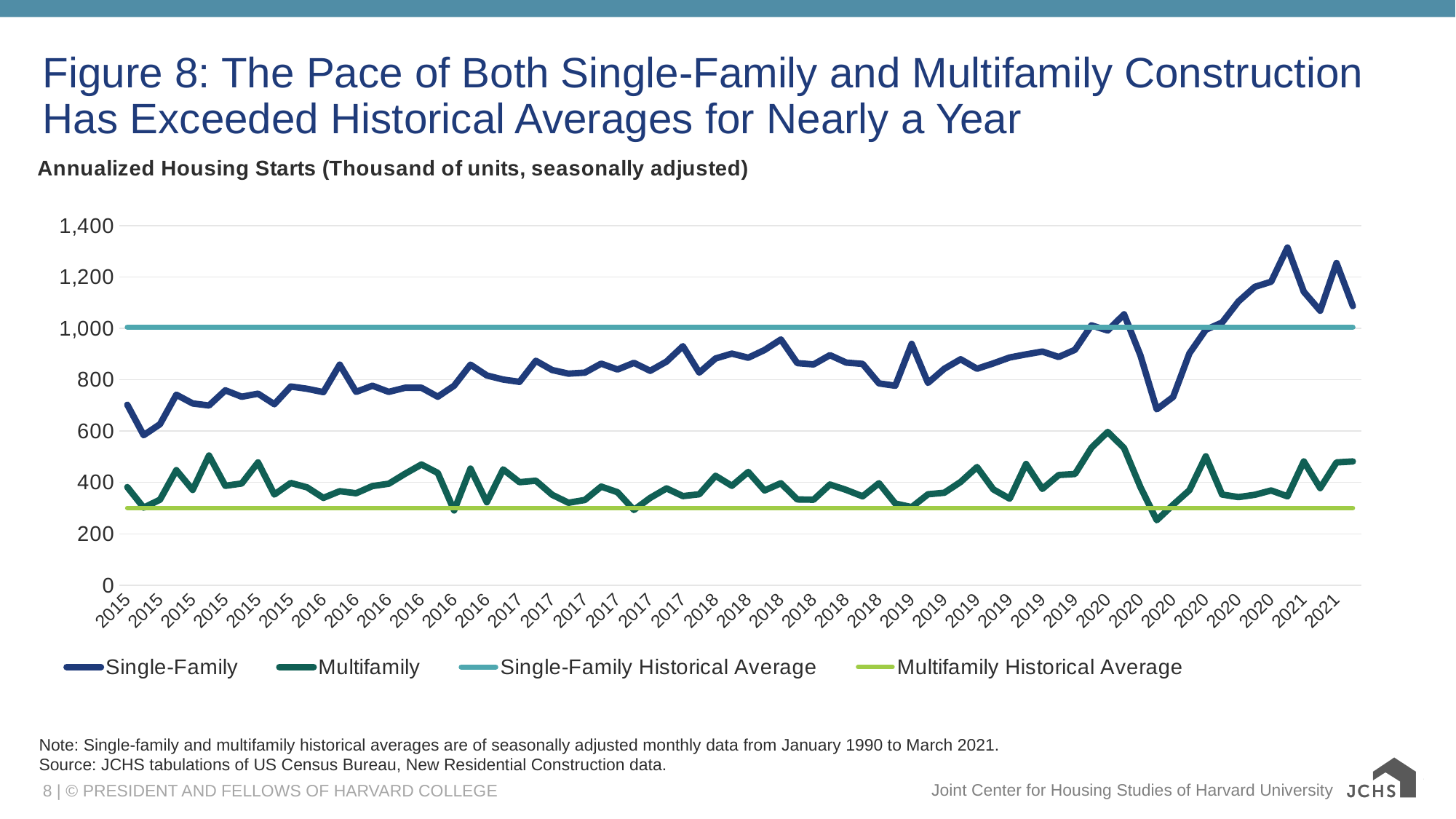
Is the Multifamily Historical Average line greater or less than 400? less Which legend entry is drawn with the light green line? Multifamily Historical Average How many series does the legend list? 4 In which year does the Single-Family series reach its lowest point? 2015 Is the highest point of the Multifamily series greater or less than 400? greater Is the highest point of the Single-Family series greater or less than 1,200? greater Overall, does the Single-Family series rise or fall from 2015 to 2021? rise What kind of chart is shown on the slide? Line chart What is the subtitle describing the units of the chart? Annualized Housing Starts (Thousand of units, seasonally adjusted) In which year does the Single-Family series reach its highest point? 2020 Which series is plotted consistently higher throughout the chart, Single-Family or Multifamily? Single-Family